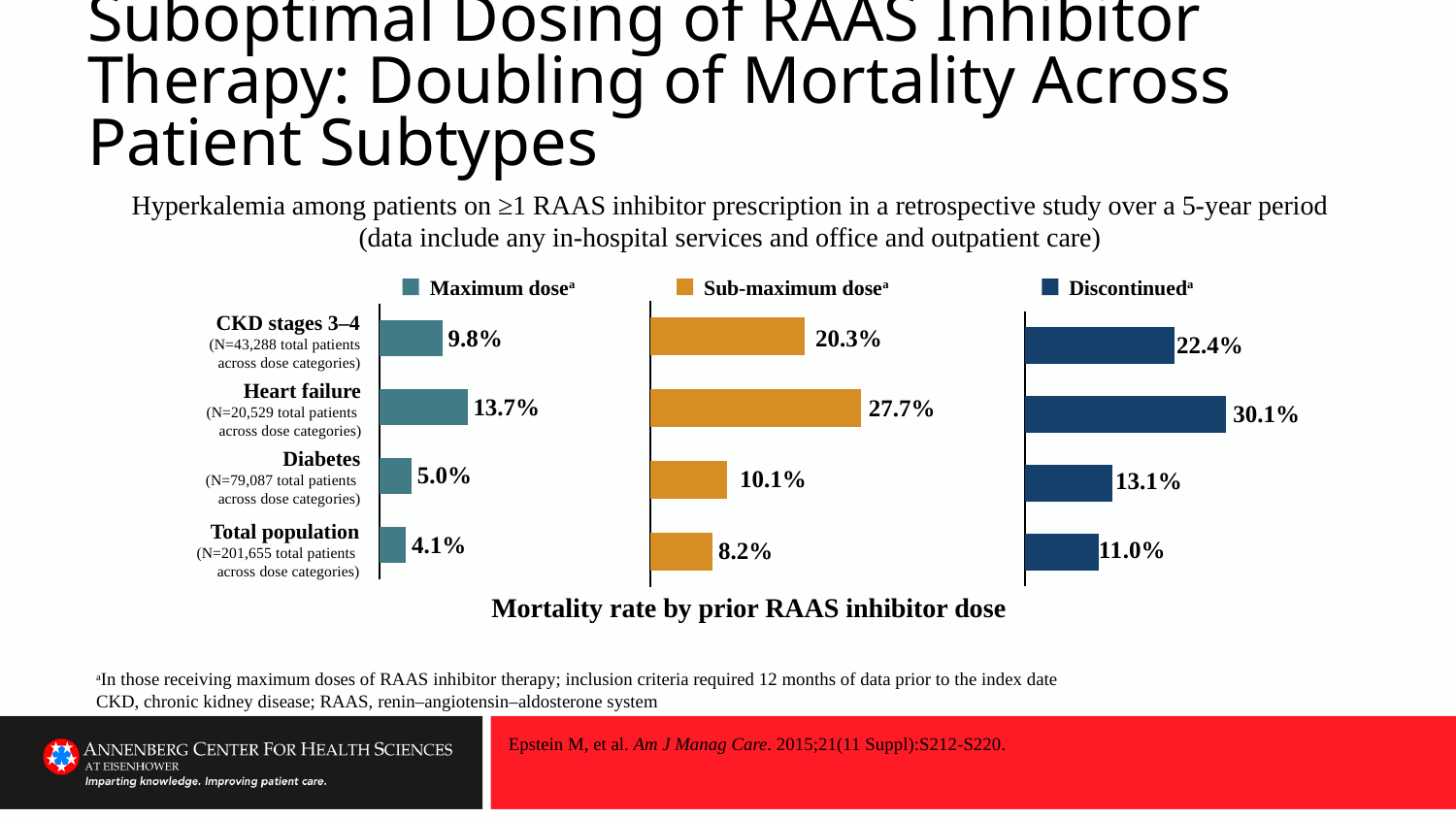
In the Discontinued chart, what is the difference between the mortality rates for CKD stages 3–4 and Diabetes? 9.3% In the Maximum dose chart, what is the mortality rate for Heart failure? 13.7% What colour are the bars in the Sub-maximum dose chart? Orange In the Discontinued chart, which patient group has the highest mortality rate? Heart failure In the Discontinued chart, what is the mortality rate for Total population? 11.0% How many patient groups are shown in the Sub-maximum dose chart? 4 In the Sub-maximum dose chart, what is the mortality rate for CKD stages 3–4? 20.3% How many dose categories are shown across the charts on the slide? 3 In the Maximum dose chart, which is larger: the mortality rate for CKD stages 3–4 or for Diabetes? CKD stages 3–4 In the Maximum dose chart, which patient group has the lowest mortality rate? Total population What type of chart is used to show mortality rate by prior RAAS inhibitor dose? Bar chart In the Sub-maximum dose chart, what is the difference between the mortality rates for Heart failure and Diabetes? 17.6%